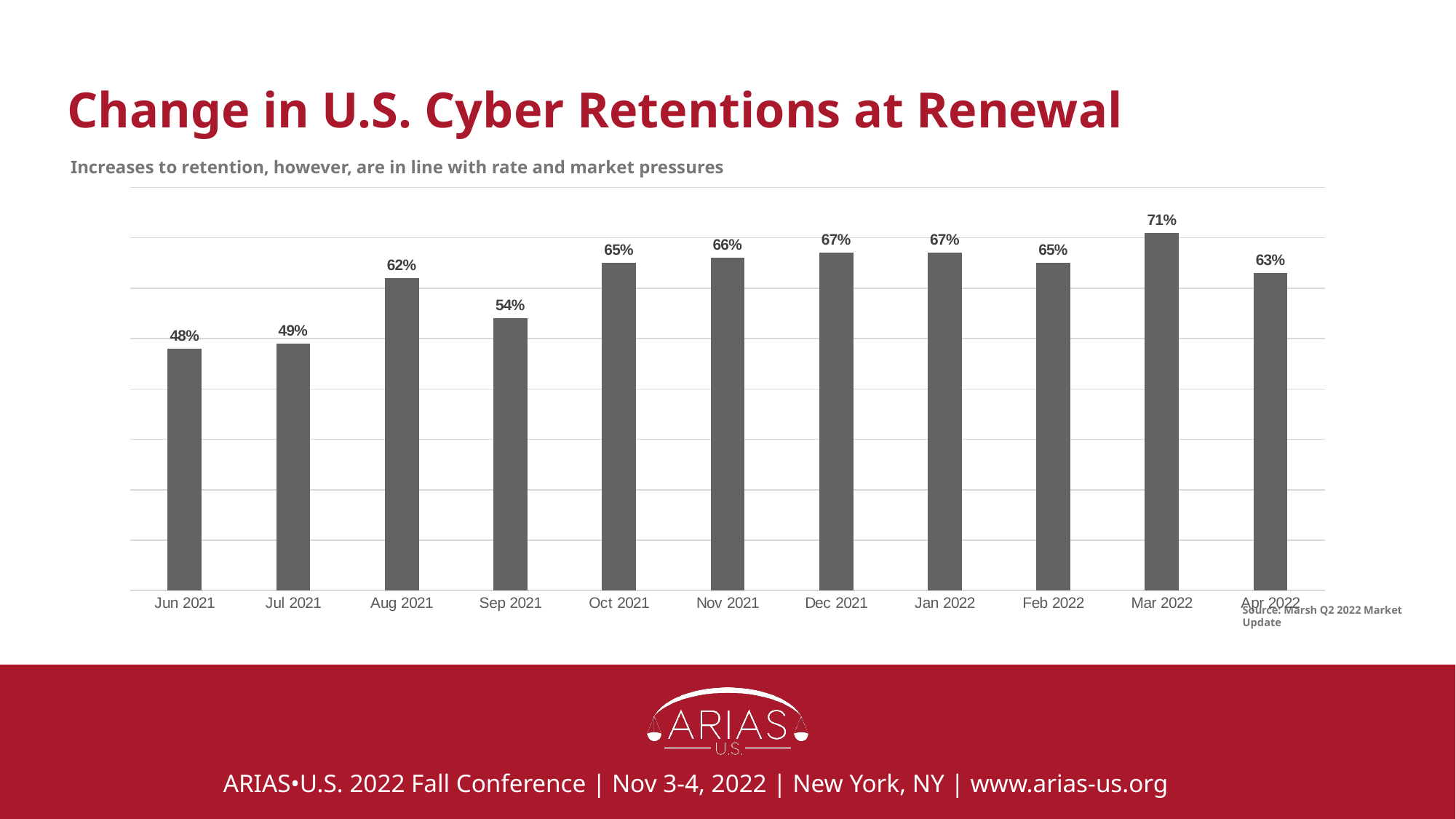
What is the value for Mar 2022? 71% What is the difference between the values for Mar 2022 and Jun 2021? 23% What kind of chart is shown on the slide? Bar chart What is the value for Jun 2021? 48% Which month has the highest value? Mar 2022 What is the value for Apr 2022? 63% How many months are shown on the x axis? 11 Which is larger, the value for Oct 2021 or the value for Apr 2022? Oct 2021 Which month has the lowest value? Jun 2021 What is the value for Sep 2021? 54% What is the title of the chart on the slide? Change in U.S. Cyber Retentions at Renewal What is the difference between the values for Aug 2021 and Sep 2021? 8%